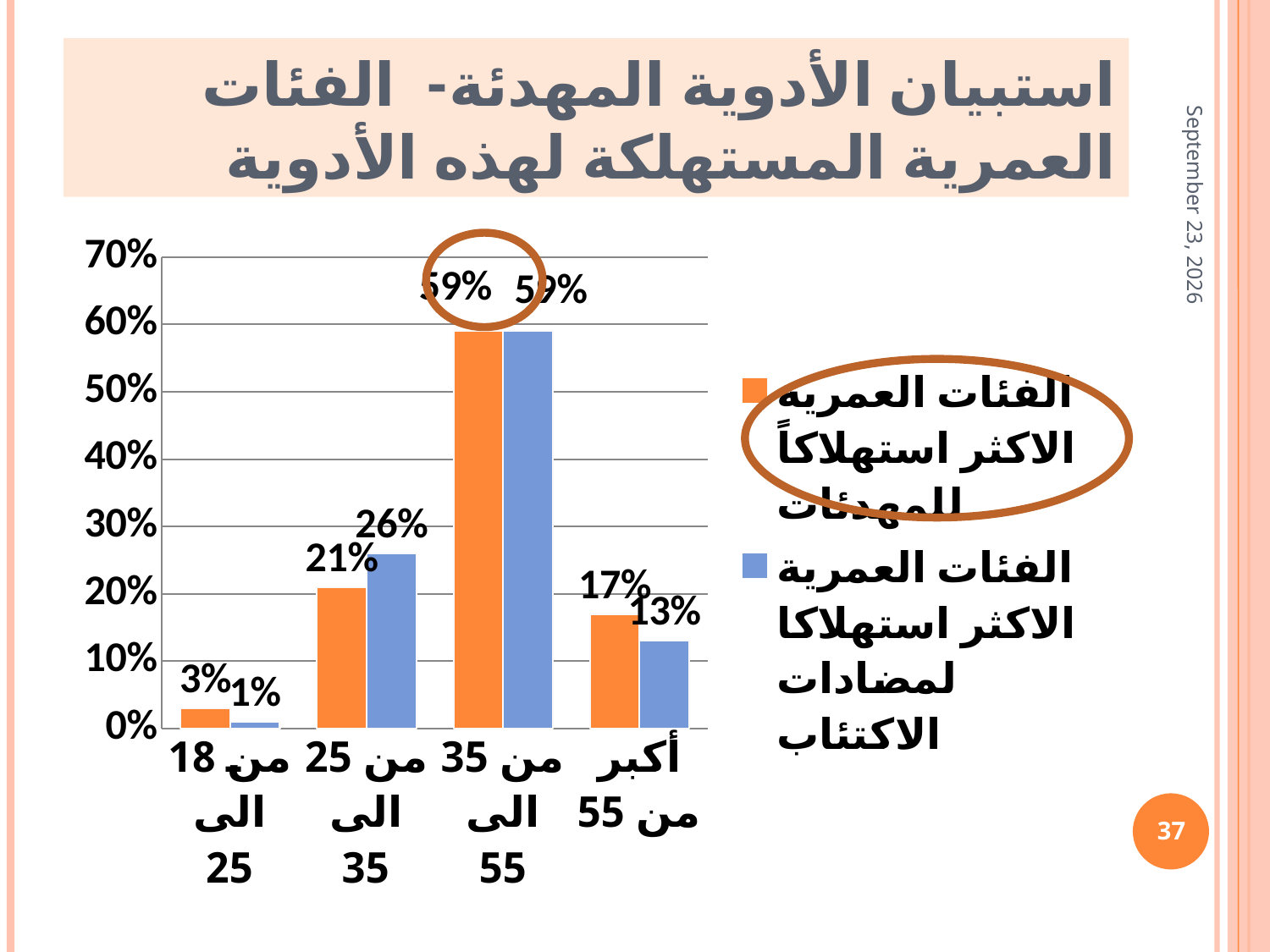
What is the value of the antidepressants series (الفئات العمرية الاكثر استهلاكا لمضادات الاكتئاب) for the age group من 25 الى 35? 26% Which age group has the lowest value in the antidepressants series? من 18 الى 25 For the age group من 25 الى 35, which series has the larger value: sedatives or antidepressants? antidepressants (الفئات العمرية الاكثر استهلاكا لمضادات الاكتئاب) What is the difference between the sedatives and antidepressants values for the age group أكبر من 55? 4% Which age group has the highest value in the sedatives series? من 35 الى 55 What is the value of the sedatives series for the age group من 18 الى 25? 3% How many age groups are shown on the x axis? 4 What colour represents the sedatives series (الفئات العمرية الاكثر استهلاكاً للمهدئات) in the legend? orange How many series does the legend list? 2 What is the value of the sedatives series (الفئات العمرية الاكثر استهلاكاً للمهدئات) for the age group من 35 الى 55? 59% What is the value of the antidepressants series for the age group أكبر من 55? 13% What kind of chart is shown on the slide? bar chart